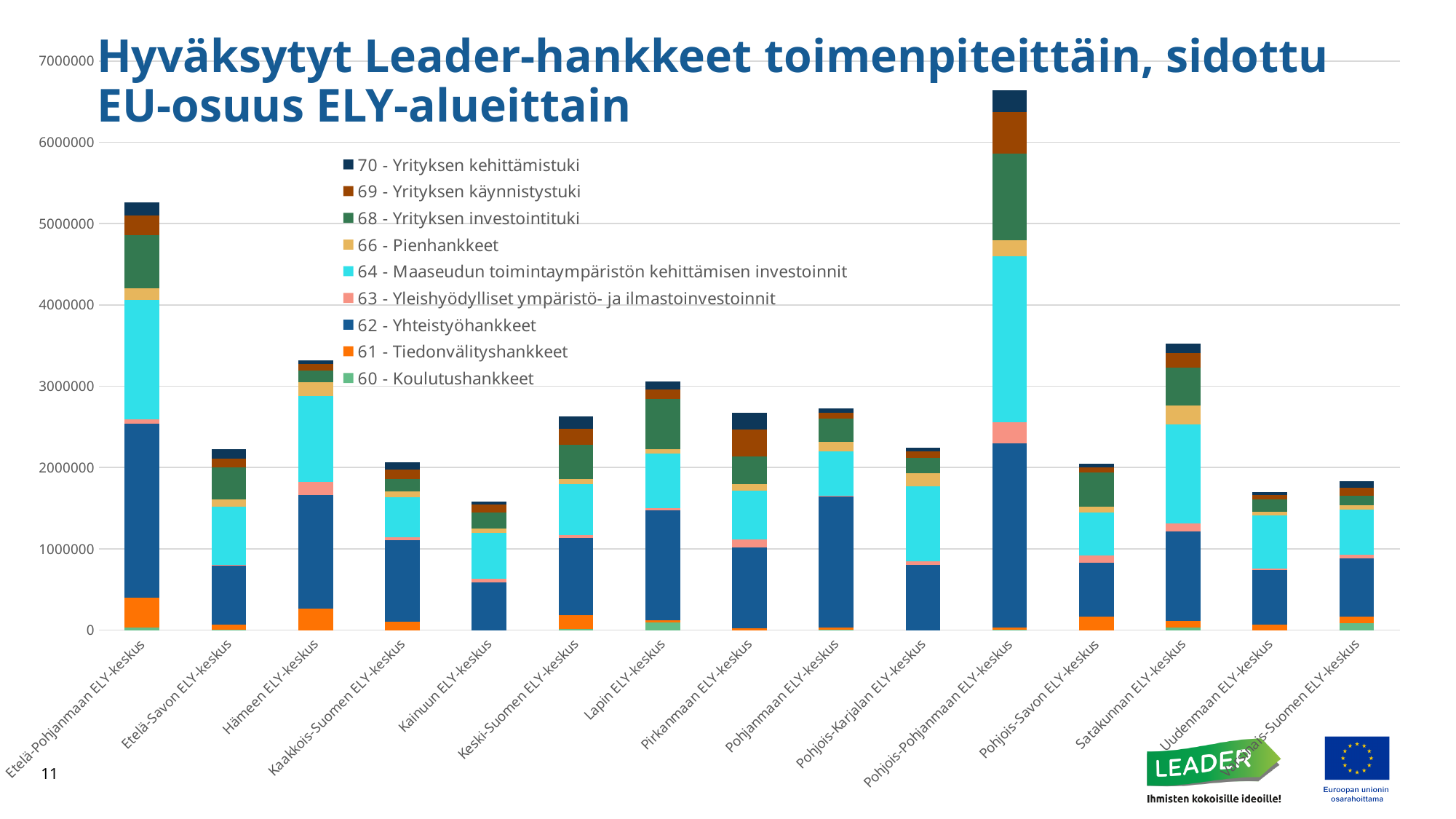
Is the total for Etelä-Pohjanmaan ELY-keskus greater or less than 5000000? greater Which legend entry is shown in dark navy at the top of the legend? 70 - Yrityksen kehittämistuki Is the total for Satakunnan ELY-keskus greater or less than 3000000? greater What is the title of the chart? Hyväksytyt Leader-hankkeet toimenpiteittäin, sidottu EU-osuus ELY-alueittain What kind of chart is shown on the slide? Stacked bar chart How many series does the legend list? 9 Which ELY-keskus has the highest total stacked bar? Pohjois-Pohjanmaan ELY-keskus Is the total for Pohjois-Pohjanmaan ELY-keskus greater or less than 6000000? greater Which has the larger total stacked bar, Etelä-Pohjanmaan ELY-keskus or Hämeen ELY-keskus? Etelä-Pohjanmaan ELY-keskus How many ELY-keskus categories are plotted along the x axis? 15 Which has the larger total stacked bar, Lapin ELY-keskus or Keski-Suomen ELY-keskus? Lapin ELY-keskus